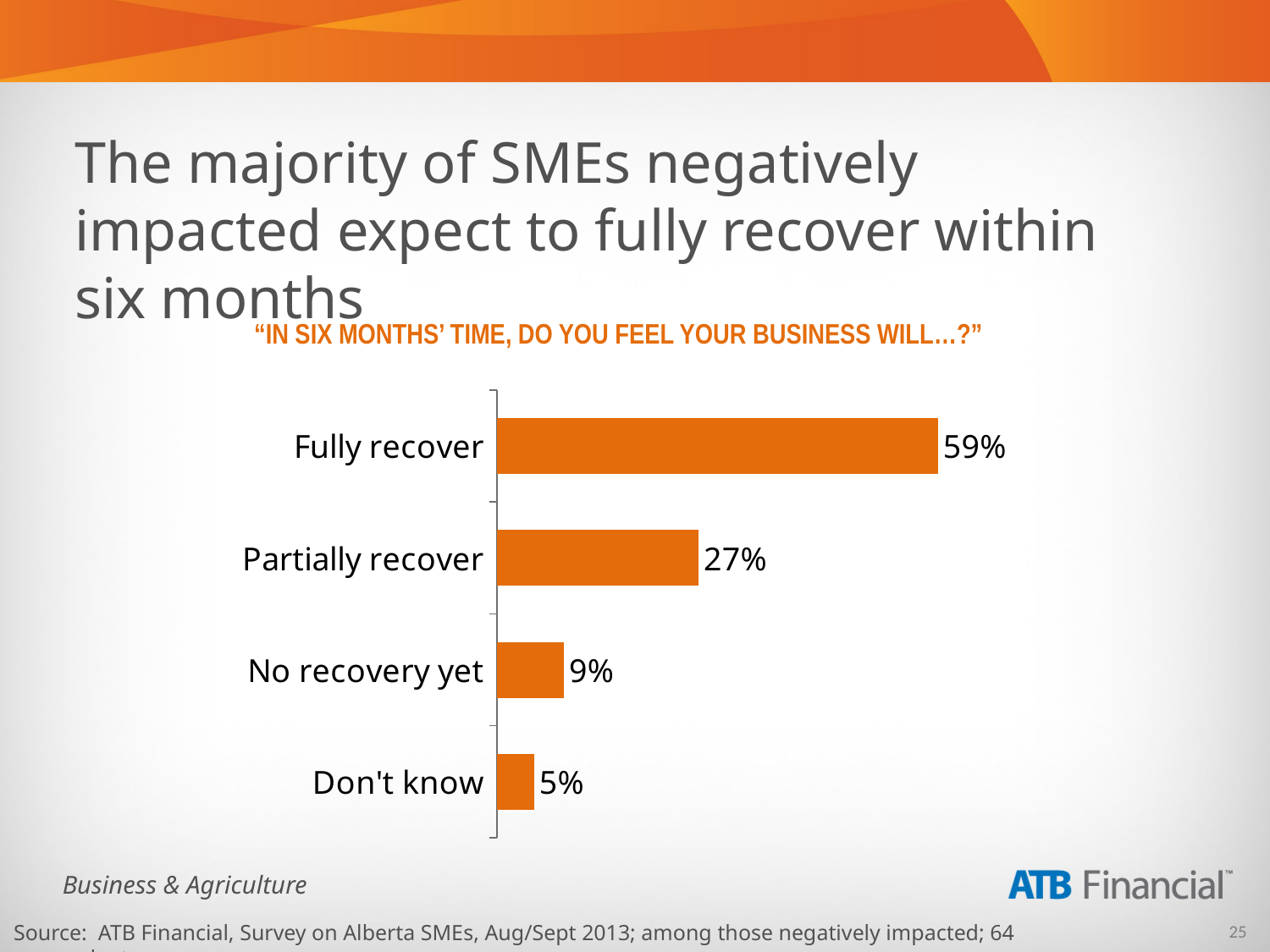
Which response category has the highest value? Fully recover What is the difference in percentage points between "Fully recover" and "Partially recover"? 32 How many response categories are shown in the chart? 4 What is the value shown for "Don't know"? 5% What question is the chart titled with? "In six months' time, do you feel your business will…?" What type of chart is shown on the slide? Bar chart Which response category has the lowest value? Don't know What percentage of respondents answered "No recovery yet"? 9% Which is larger, the value for "Partially recover" or the value for "No recovery yet"? Partially recover What is the value shown for "Partially recover"? 27% What is the difference in percentage points between "No recovery yet" and "Don't know"? 4 What percentage of respondents expect their business to fully recover in six months' time? 59%